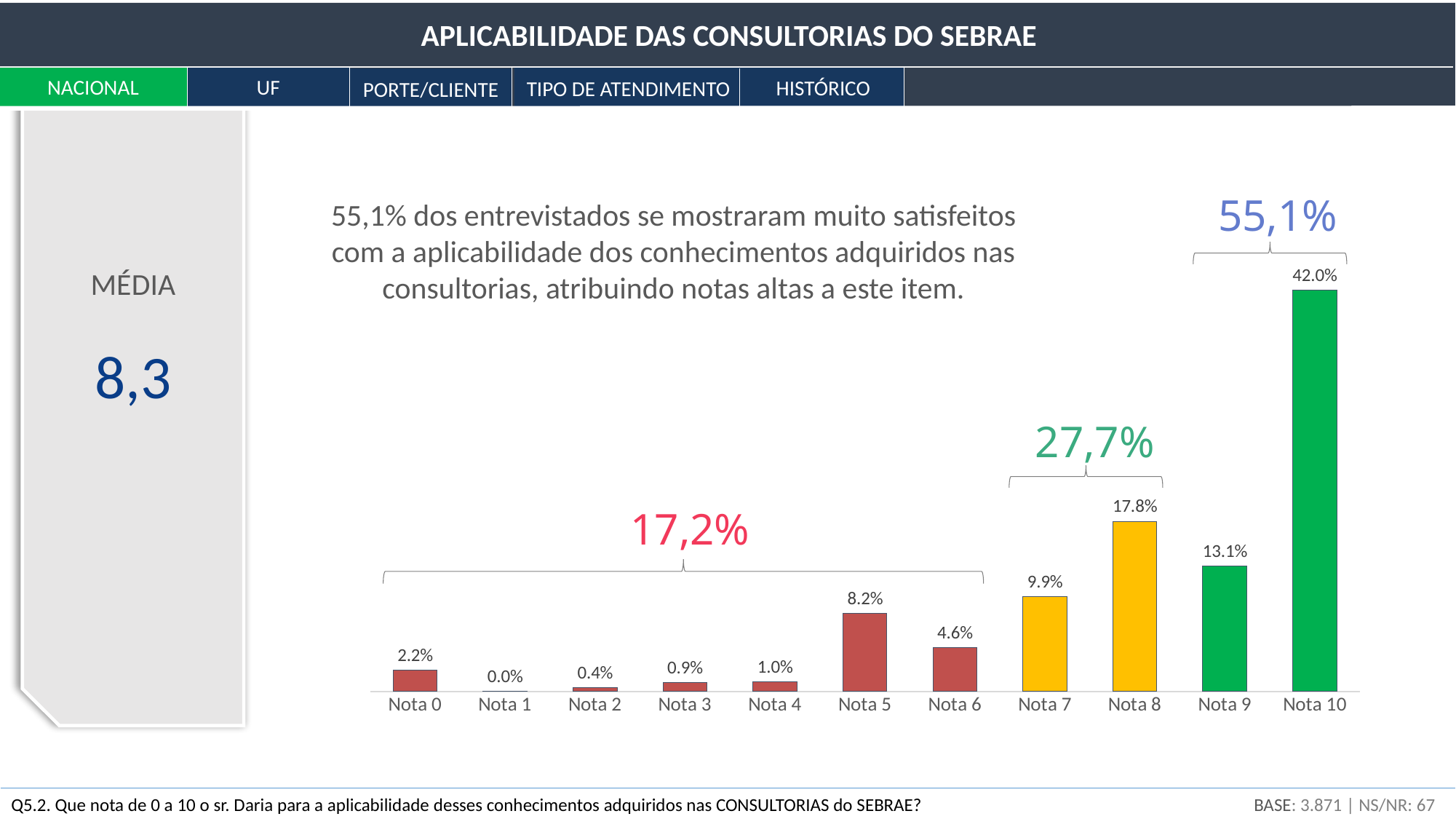
What is the difference between the values for Nota 10 and Nota 9? 28.9% Which category has the highest value? Nota 10 What kind of chart is shown? Bar chart What is the value for Nota 1? 0.0% What is the value for Nota 5? 8.2% How many categories are shown on the x axis? 11 Which category has the lowest value? Nota 1 What percentage is shown above the bracket grouping Nota 7 and Nota 8? 27,7% What is the value for Nota 10? 42.0% What is the value for Nota 8? 17.8% Which is larger, the value for Nota 7 or the value for Nota 6? Nota 7